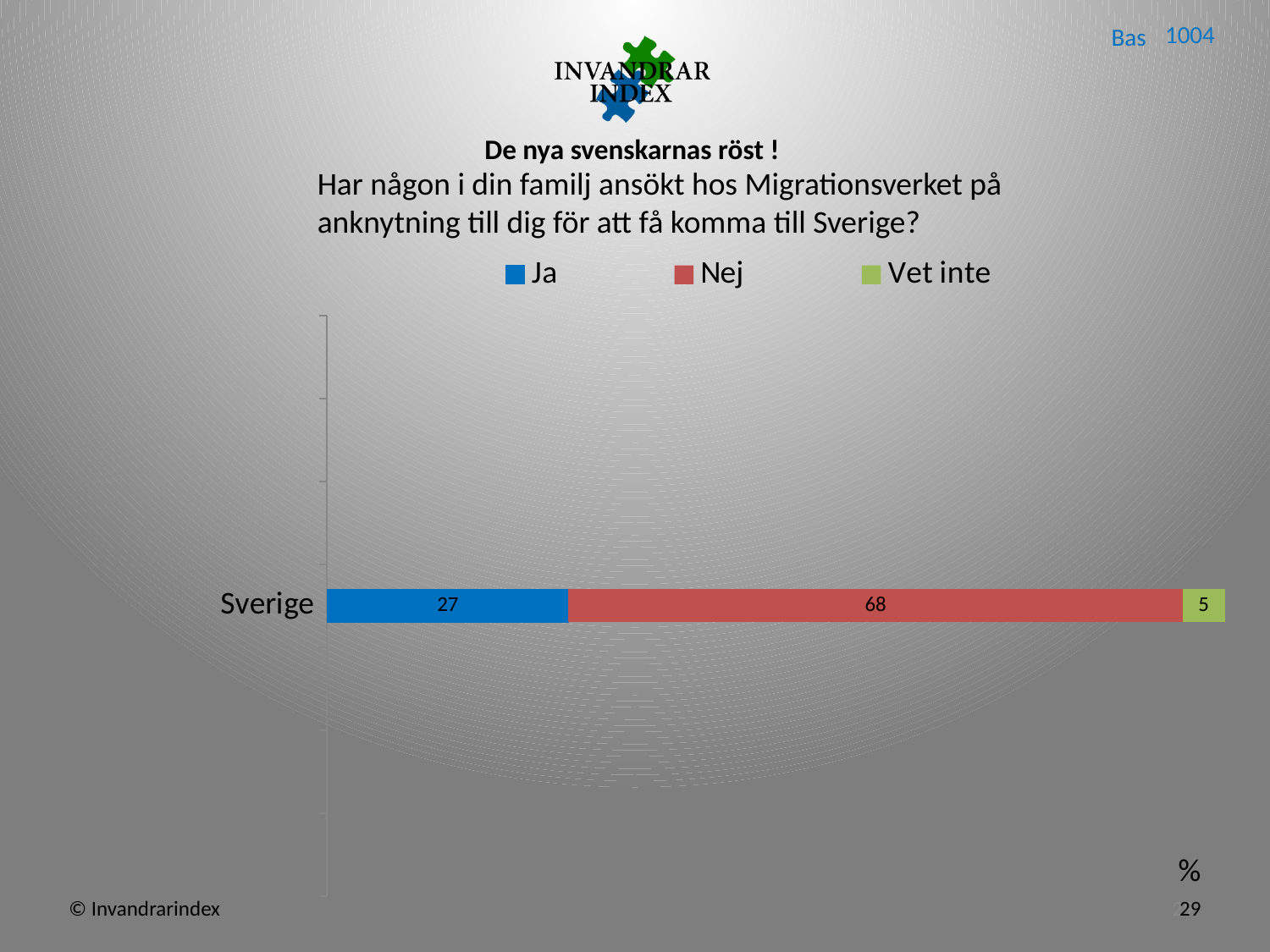
How many categories are shown on the chart? 1 Which series has the highest value for Sverige? Nej What is the difference between the Nej and Ja values for Sverige? 41 What colour represents Nej in the legend? Red What is the value for Nej for Sverige? 68 What is the total of the stacked bar for Sverige? 100 What kind of chart is shown? Stacked bar chart What is the value for Ja for Sverige? 27 Which series has the lowest value for Sverige? Vet inte What is the value for Vet inte for Sverige? 5 Which is larger for Sverige, Ja or Vet inte? Ja How many series does the legend list? 3